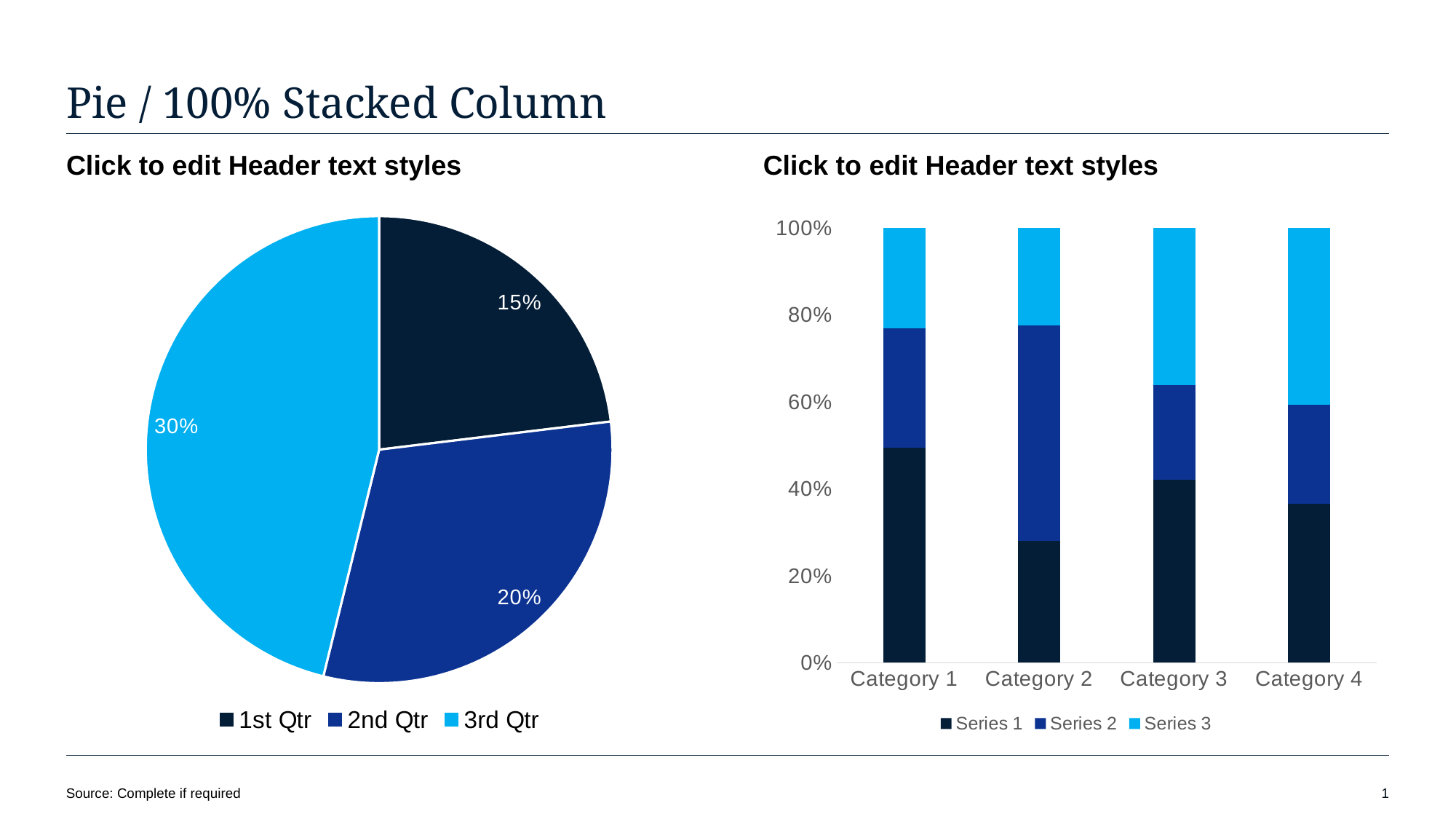
On the pie chart on the left, which quarter has the smallest slice? 1st Qtr On the stacked bar chart on the right, what is the total height of each stacked bar? 100% On the pie chart on the left, which quarter has the largest slice? 3rd Qtr On the stacked bar chart on the right, how many categories are shown on the x axis? 4 On the pie chart on the left, what is the value shown for 3rd Qtr? 30% On the stacked bar chart on the right, how many series does the legend list? 3 On the stacked bar chart on the right, is the Series 1 value for Category 2 greater or less than 40%? less On the pie chart on the left, what is the value shown for 1st Qtr? 15% On the stacked bar chart on the right, which category has the smallest Series 1 segment? Category 2 What kind of chart is on the right side of the slide? Stacked bar chart On the pie chart on the left, what is the difference between the 3rd Qtr and 1st Qtr values? 15% On the pie chart on the left, how many slices are there? 3